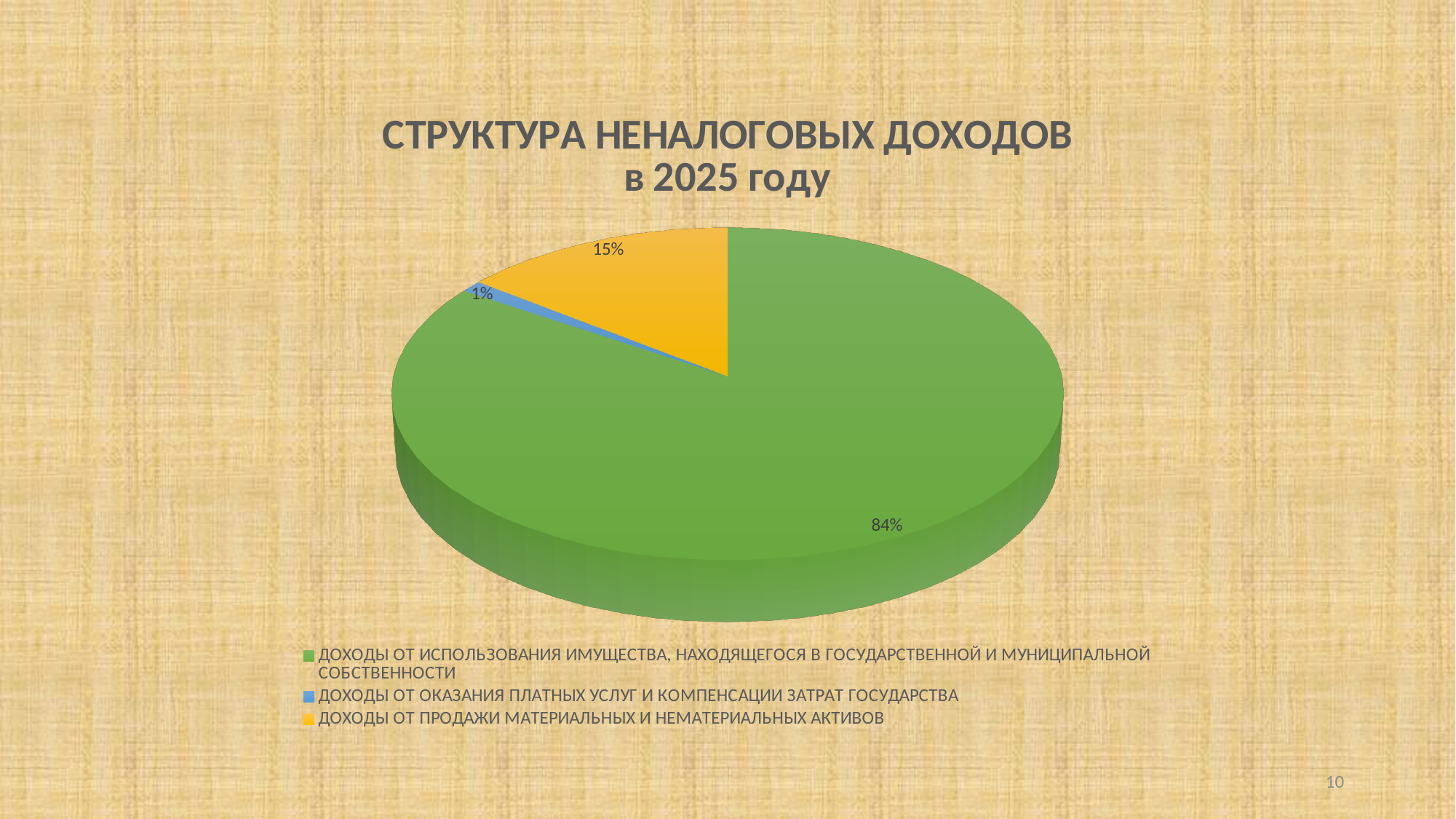
What share of the pie is labelled for ДОХОДЫ ОТ ОКАЗАНИЯ ПЛАТНЫХ УСЛУГ И КОМПЕНСАЦИИ ЗАТРАТ ГОСУДАРСТВА? 1% Which is larger: the share for ДОХОДЫ ОТ ПРОДАЖИ МАТЕРИАЛЬНЫХ И НЕМАТЕРИАЛЬНЫХ АКТИВОВ or the share for ДОХОДЫ ОТ ОКАЗАНИЯ ПЛАТНЫХ УСЛУГ И КОМПЕНСАЦИИ ЗАТРАТ ГОСУДАРСТВА? ДОХОДЫ ОТ ПРОДАЖИ МАТЕРИАЛЬНЫХ И НЕМАТЕРИАЛЬНЫХ АКТИВОВ Which category has the largest slice of the pie? ДОХОДЫ ОТ ИСПОЛЬЗОВАНИЯ ИМУЩЕСТВА, НАХОДЯЩЕГОСЯ В ГОСУДАРСТВЕННОЙ И МУНИЦИПАЛЬНОЙ СОБСТВЕННОСТИ What kind of chart is shown on the slide? Pie chart What is the difference in percentage points between the 84% slice and the 15% slice? 69 percentage points What share of the pie is labelled for ДОХОДЫ ОТ ПРОДАЖИ МАТЕРИАЛЬНЫХ И НЕМАТЕРИАЛЬНЫХ АКТИВОВ? 15% What share of the pie is labelled for ДОХОДЫ ОТ ИСПОЛЬЗОВАНИЯ ИМУЩЕСТВА, НАХОДЯЩЕГОСЯ В ГОСУДАРСТВЕННОЙ И МУНИЦИПАЛЬНОЙ СОБСТВЕННОСТИ? 84% What is the difference in percentage points between the 15% slice and the 1% slice? 14 percentage points Which category has the smallest slice of the pie? ДОХОДЫ ОТ ОКАЗАНИЯ ПЛАТНЫХ УСЛУГ И КОМПЕНСАЦИИ ЗАТРАТ ГОСУДАРСТВА What colour is the slice for ДОХОДЫ ОТ ПРОДАЖИ МАТЕРИАЛЬНЫХ И НЕМАТЕРИАЛЬНЫХ АКТИВОВ? Yellow How many categories does the pie chart show? 3 What is the title of the chart? СТРУКТУРА НЕНАЛОГОВЫХ ДОХОДОВ в 2025 году